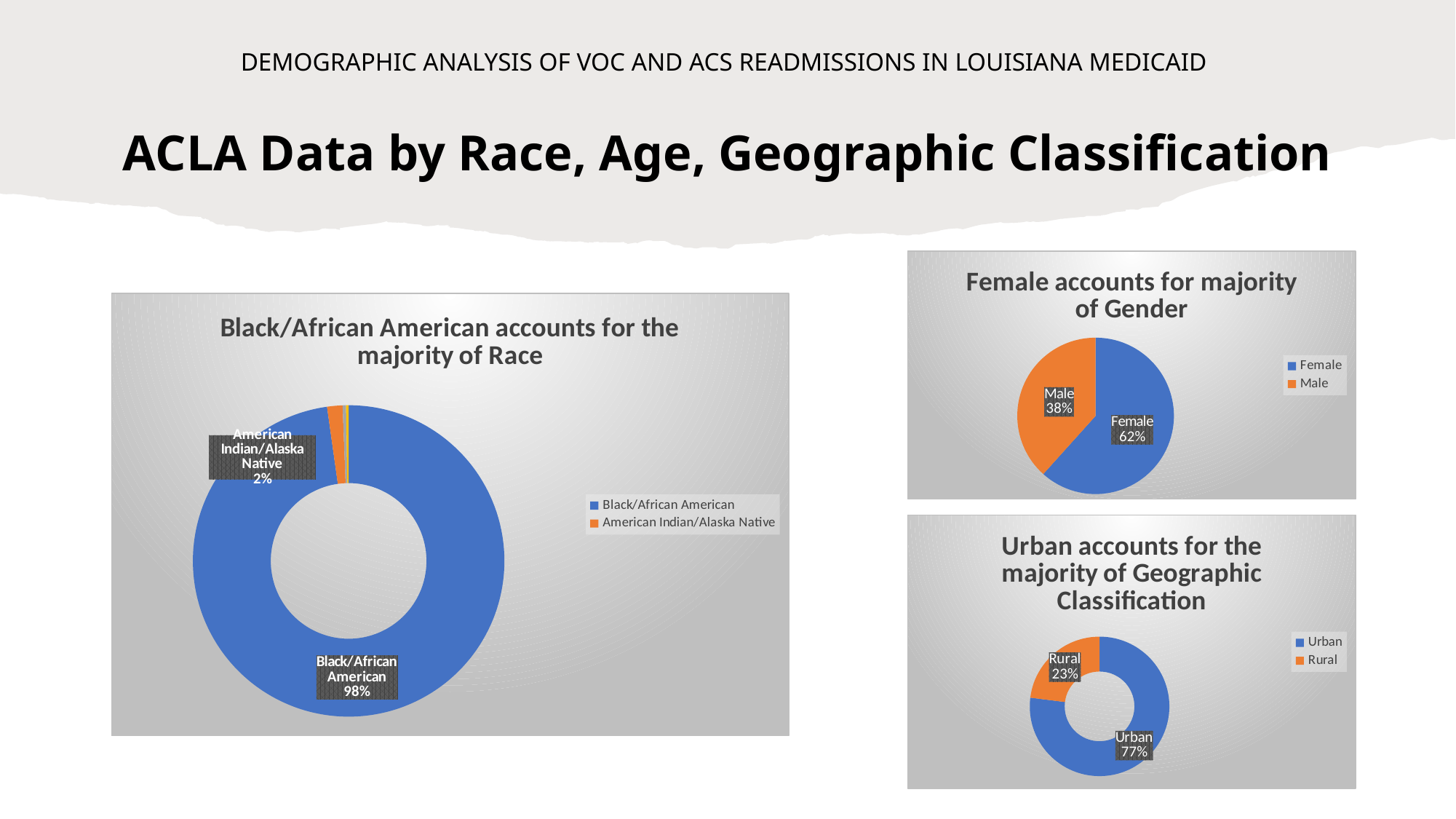
In the 'Urban accounts for the majority of Geographic Classification' chart, what is the difference between the Urban and Rural shares? 54% In the 'Black/African American accounts for the majority of Race' chart, which category has the smallest share? American Indian/Alaska Native In the 'Female accounts for majority of Gender' chart, what is the value for Female? 62% In the 'Urban accounts for the majority of Geographic Classification' chart, what is the value for Rural? 23% What kind of chart is the 'Female accounts for majority of Gender' chart? Pie chart In the 'Female accounts for majority of Gender' chart, what is the difference between the Female and Male shares? 24% In the 'Black/African American accounts for the majority of Race' chart, what share does Black/African American account for? 98% How many categories does the legend of the 'Urban accounts for the majority of Geographic Classification' chart list? 2 In the 'Female accounts for majority of Gender' chart, what is the value for Male? 38% In the 'Urban accounts for the majority of Geographic Classification' chart, what is the value for Urban? 77% In the 'Black/African American accounts for the majority of Race' chart, what share does American Indian/Alaska Native account for? 2% In the 'Female accounts for majority of Gender' chart, which category is larger, Female or Male? Female